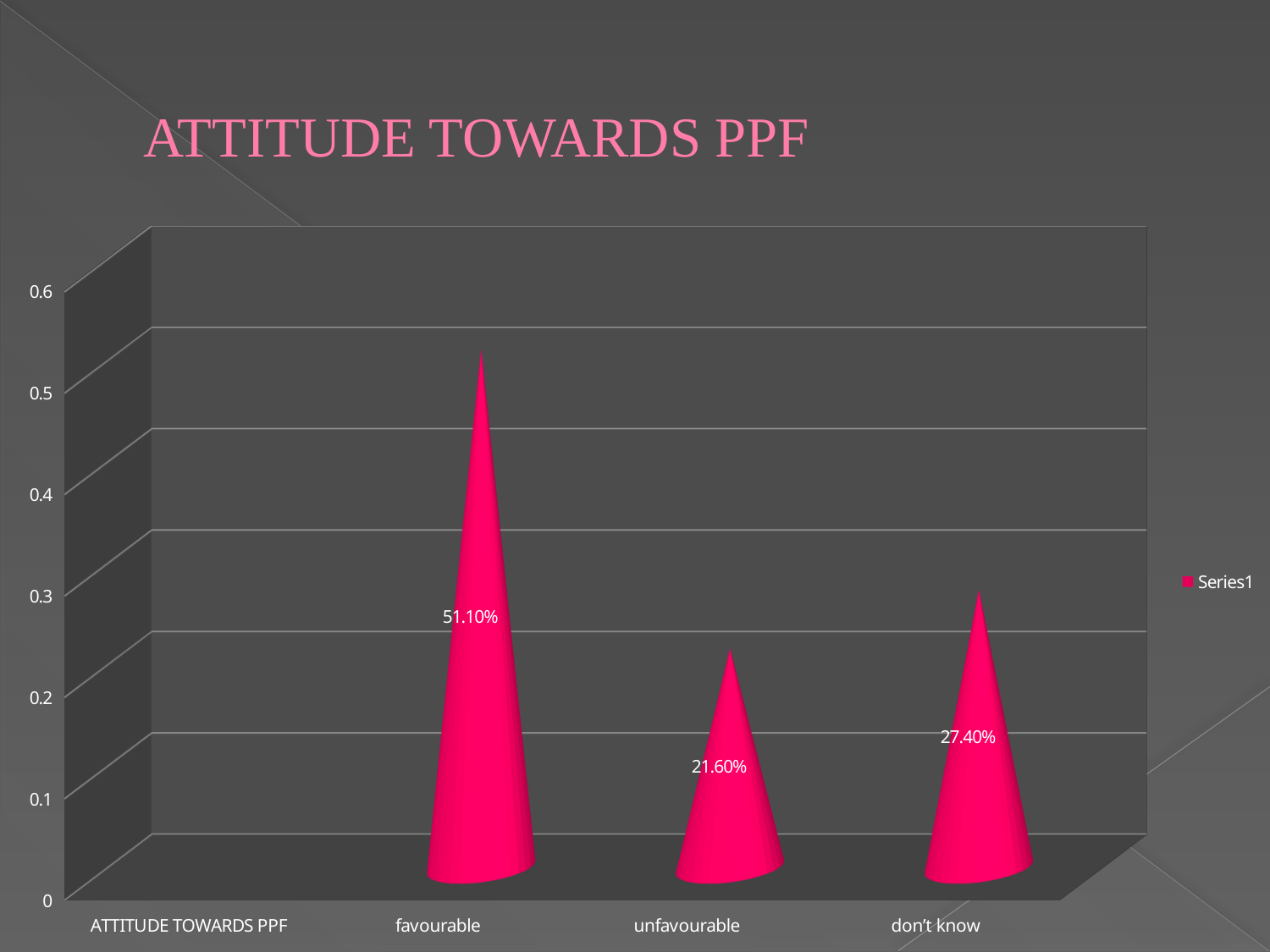
Is the value for favourable greater or less than 0.4? greater Which category has the lowest value? unfavourable Which is larger, the value for don't know or the value for unfavourable? don't know What is the difference between the values for favourable and unfavourable? 29.50% How many bars are plotted on the chart? 3 Which category has the highest value? favourable What is the difference between the values for don't know and unfavourable? 5.80% How many series does the legend list? 1 What is the title of the chart? ATTITUDE TOWARDS PPF What is the value for don't know? 27.40% What is the value for favourable? 51.10% What is the value for unfavourable? 21.60%